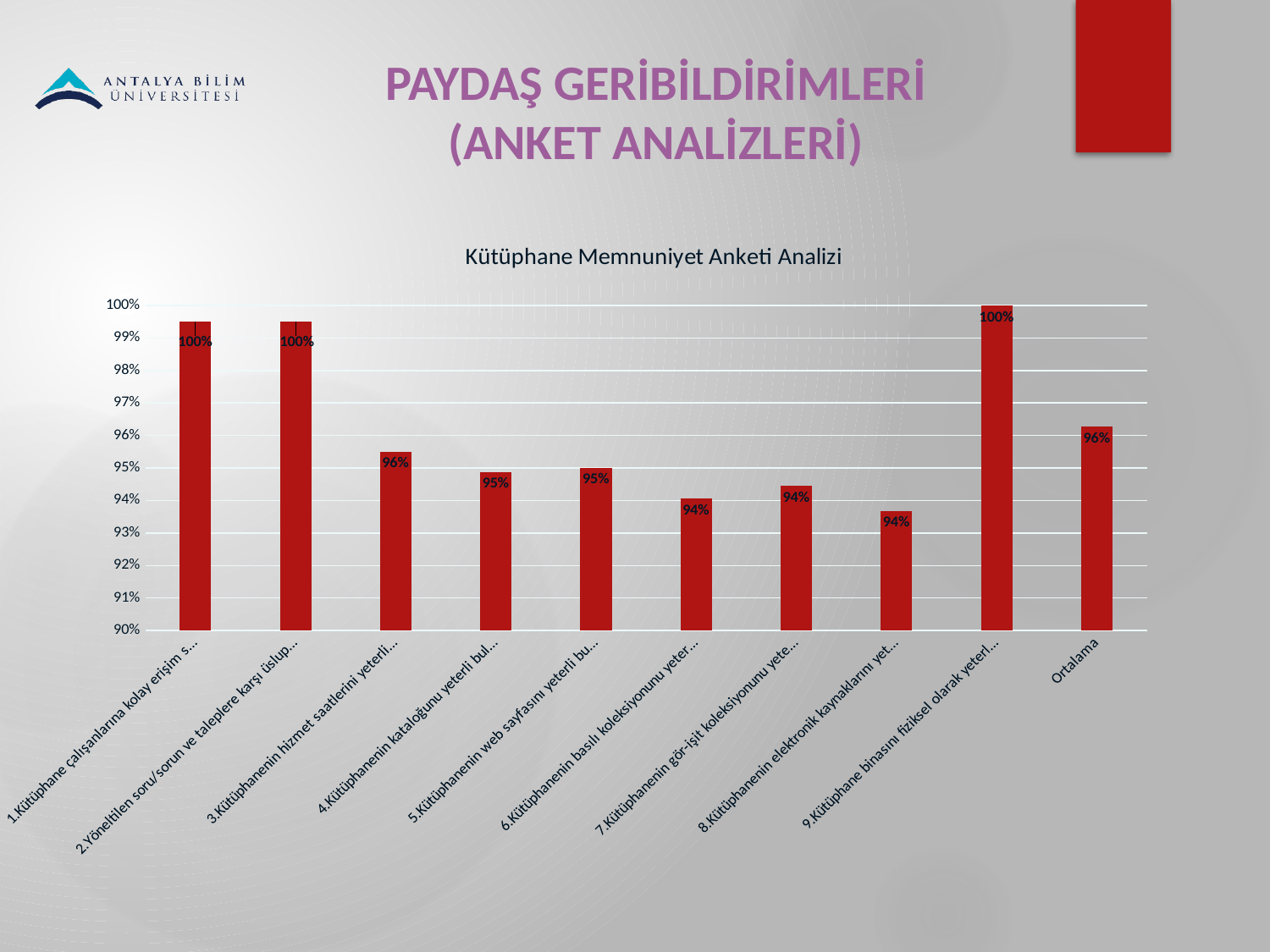
What is the value shown for the category "9.Kütüphane binasını fiziksel olarak yeterli..."? 100% What is the difference between the "Ortalama" value and the value for "8.Kütüphanenin elektronik kaynaklarını yet..."? 2 percentage points Which has the larger value: "3.Kütüphanenin hizmet saatlerini yeterli..." or "6.Kütüphanenin basılı koleksiyonunu yeter..."? 3.Kütüphanenin hizmet saatlerini yeterli... At what value does the vertical axis of the chart start? 90% What is the value shown for the category "6.Kütüphanenin basılı koleksiyonunu yeter..."? 94% What is the title of the chart on the slide? Kütüphane Memnuniyet Anketi Analizi Is the value for "7.Kütüphanenin gör-işit koleksiyonunu yete..." greater or less than 95%? less What is the value shown for the category "3.Kütüphanenin hizmet saatlerini yeterli..."? 96% How many categories (bars) does the chart show? 10 What kind of chart is shown on the slide? bar chart What is the value shown for the "Ortalama" bar? 96% What is the value shown for the category "4.Kütüphanenin kataloğunu yeterli bul..."? 95%